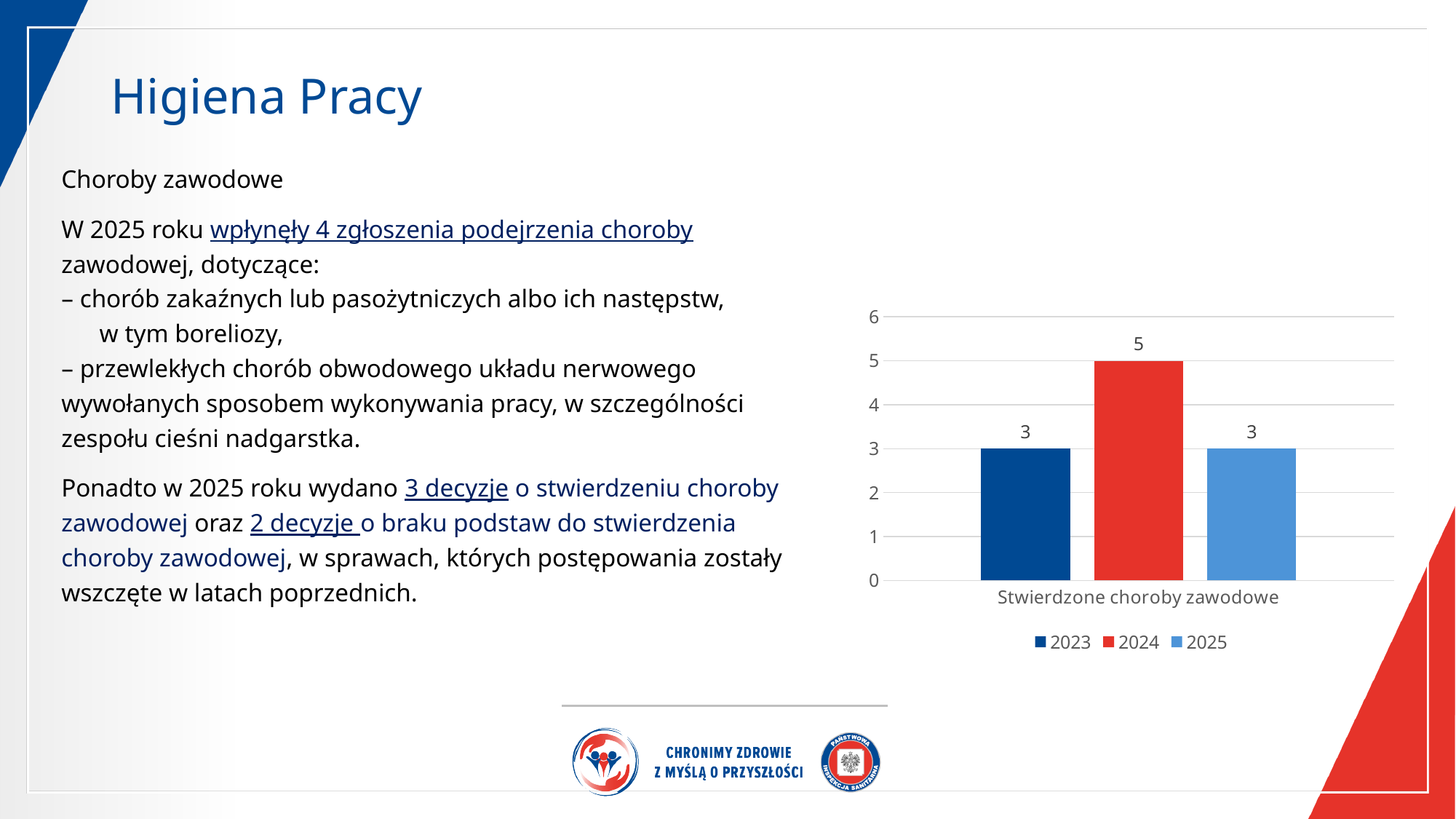
What is the total of the three bars in the chart? 11 Which year has the highest value in the chart? 2024 Is the value for 2024 greater or less than 4? greater What is the difference between the values for 2024 and 2025? 2 Which is larger, the value for 2023 or the value for 2024? 2024 What colour is the bar for 2024? red What is the value for 2024 in the chart? 5 How many series does the legend list? 3 What is the value for 2025 in the chart? 3 What is the value for 2023 in the chart? 3 What is the category label shown on the x axis of the chart? Stwierdzone choroby zawodowe What kind of chart is shown on the slide? bar chart